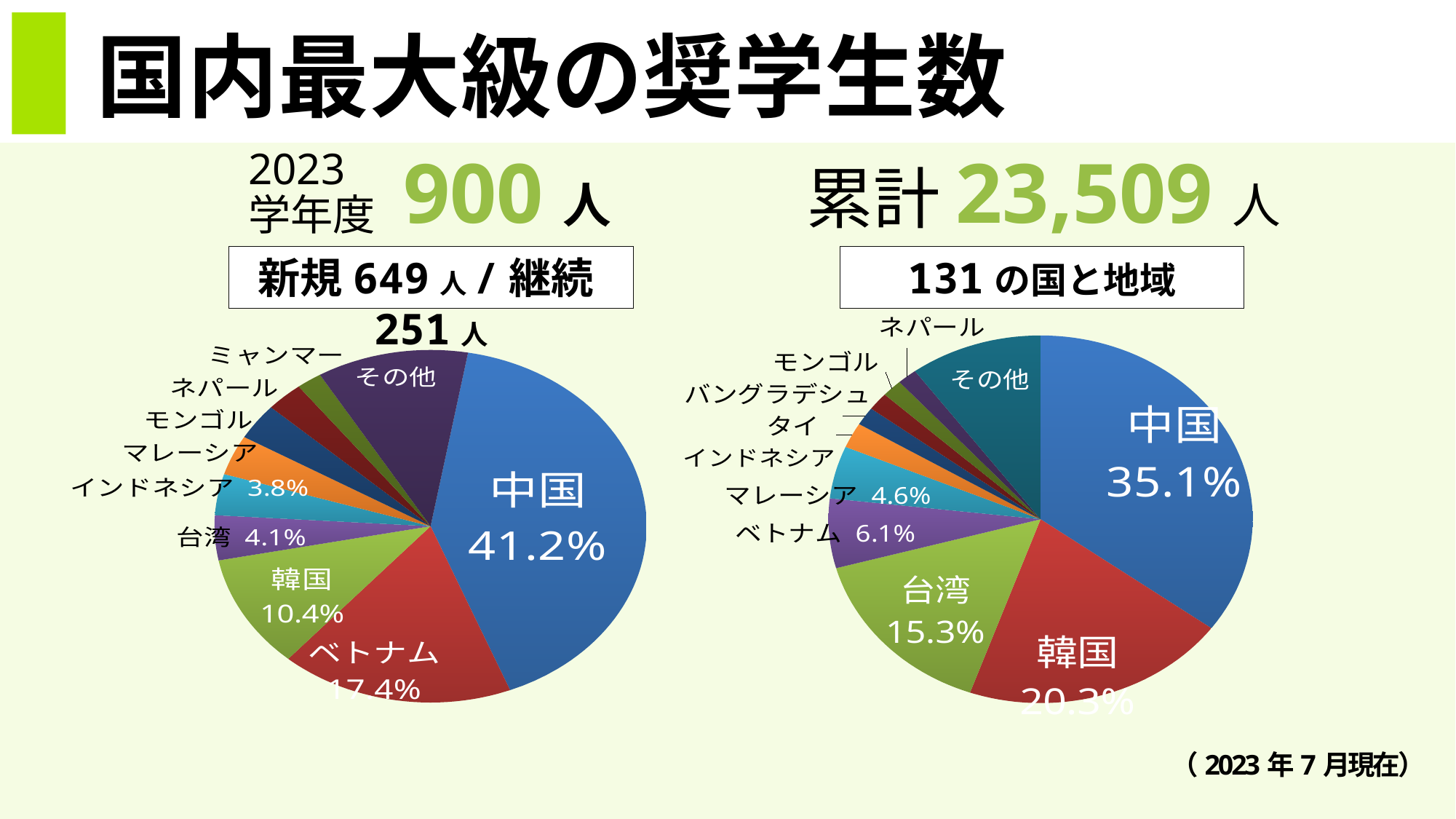
In the left pie chart (2023学年度), what is the difference between the shares of 台湾 and インドネシア? 0.3% In the right pie chart (累計), what share does マレーシア have? 4.6% In the left pie chart (2023学年度), what share does ベトナム have? 17.4% In the left pie chart (2023学年度), which category has the largest slice? 中国 In the right pie chart (累計), which is larger, the share of 韓国 or the share of ベトナム? 韓国 What type of chart is used on the left side of the slide? Pie chart In the right pie chart (累計), what share does 台湾 have? 15.3% In the left pie chart (2023学年度), what share does 韓国 have? 10.4% How many categories are shown in the right pie chart (累計)? 11 In the right pie chart (累計), what is the difference between the shares of 中国 and 韓国? 14.8% In the left pie chart (2023学年度), what share does 中国 have? 41.2% In the right pie chart (累計), what share does 中国 have? 35.1%